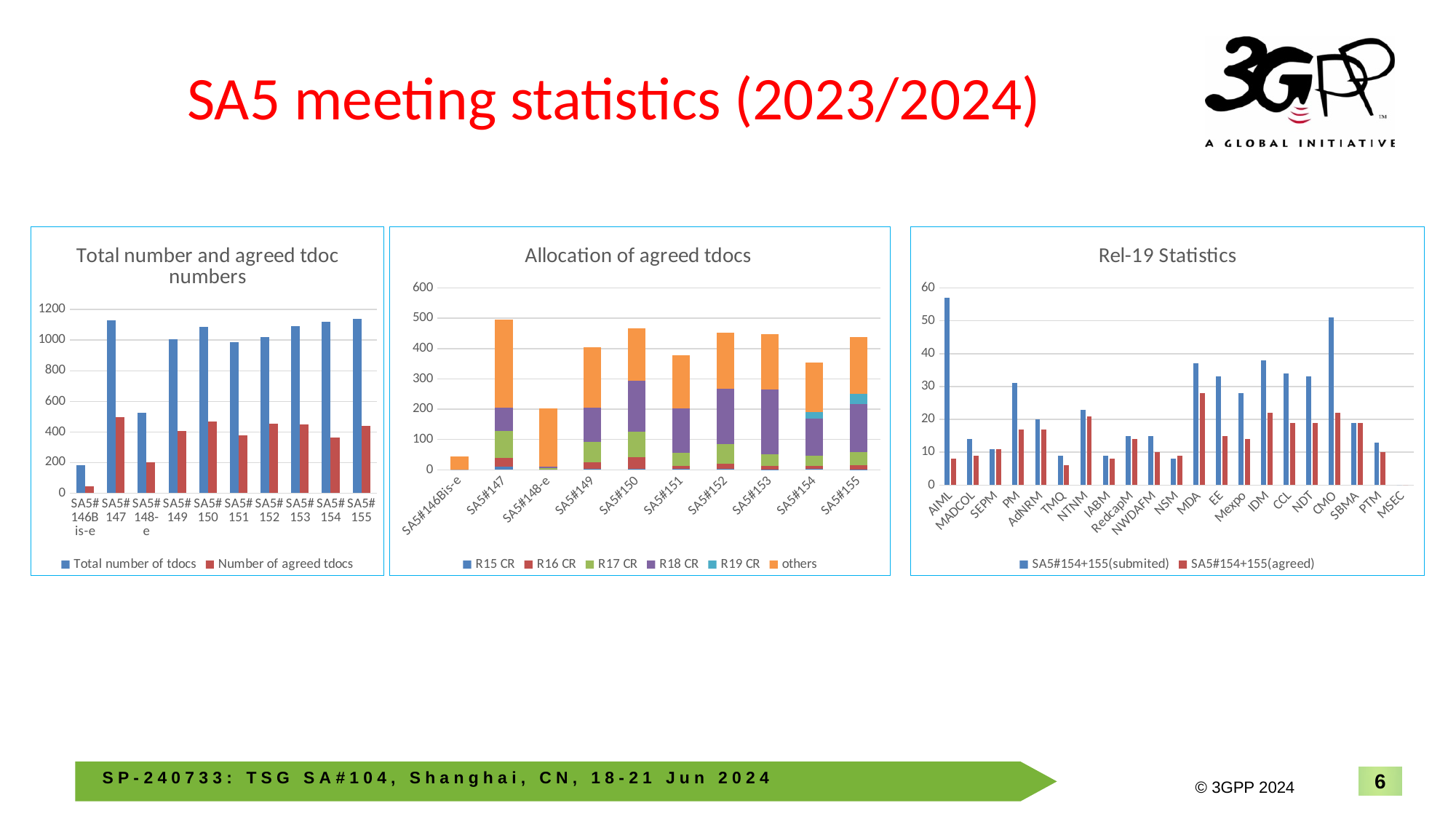
In the 'Rel-19 Statistics' chart, which category has the highest SA5#154+155(submited) value? AIML In the 'Allocation of agreed tdocs' chart, is the total for SA5#148-e greater or less than 300? less What kind of chart is the 'Allocation of agreed tdocs' chart? Stacked bar chart How many series does the legend of the 'Allocation of agreed tdocs' chart list? 6 In the 'Total number and agreed tdoc numbers' chart, is the total number of tdocs for SA5#148-e greater or less than 600? less In the 'Rel-19 Statistics' chart, is the SA5#154+155(agreed) value for MDA greater or less than 20? greater In the 'Total number and agreed tdoc numbers' chart, which meeting has the highest number of agreed tdocs? SA5#147 In the 'Rel-19 Statistics' chart, which is larger for CMO: the submitted value or the agreed value? Submitted In the 'Allocation of agreed tdocs' chart, which meeting has the tallest stacked bar? SA5#147 How many meetings are shown on the x axis of the 'Total number and agreed tdoc numbers' chart? 10 In the 'Total number and agreed tdoc numbers' chart, which meeting has the lowest total number of tdocs? SA5#146Bis-e